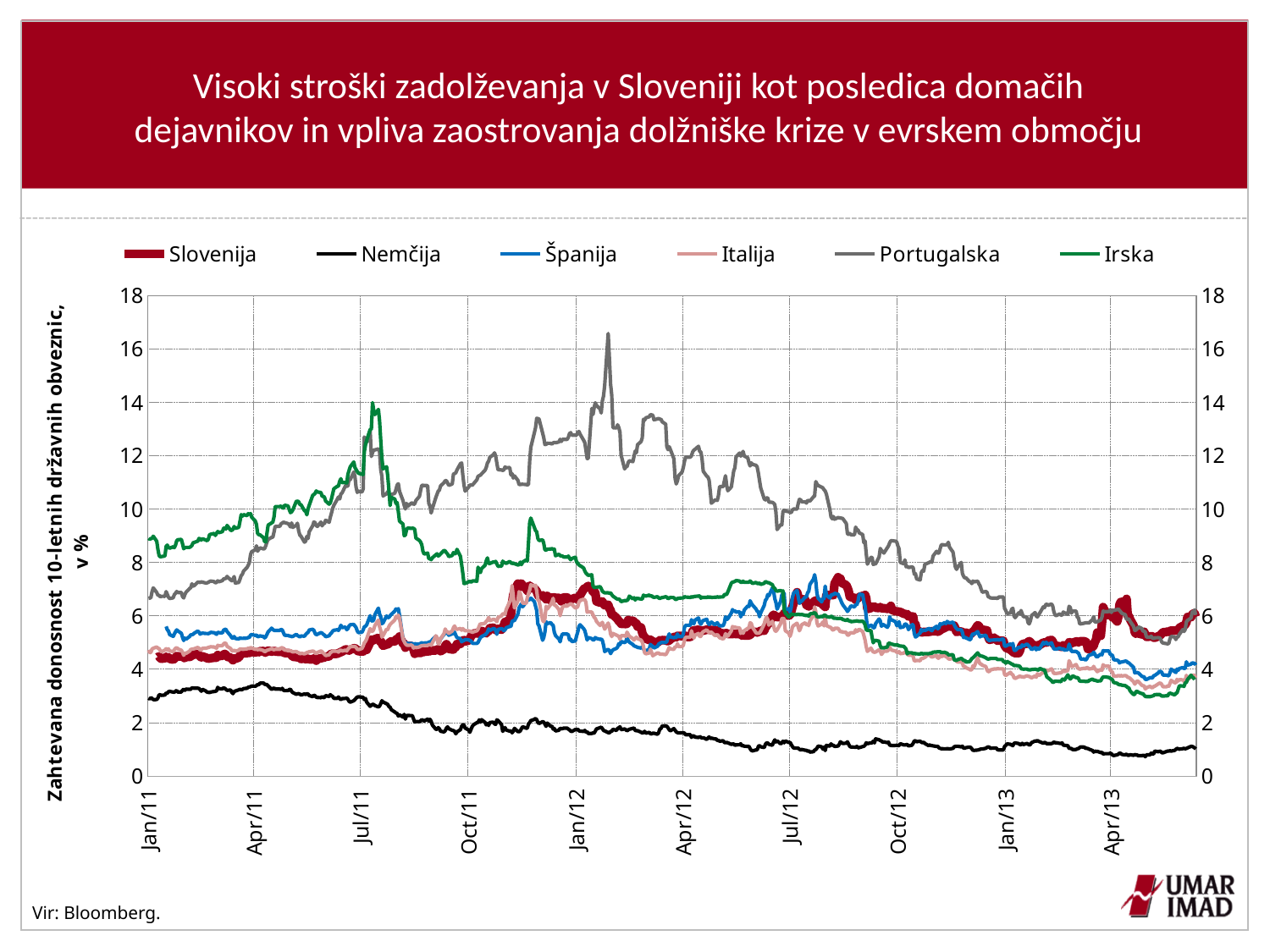
At Jan/11, which is higher, Irska or Slovenija? Irska How many series does the legend list? 6 Does the value for Nemčija rise or fall from Jan/11 to Apr/13? fall Which series has the lowest values across the whole period? Nemčija Which series reaches the highest value on the chart? Portugalska What kind of chart is shown on the slide? line chart Is the peak value for Portugalska greater or less than 14? greater Does the value for Portugalska rise or fall from Jul/12 to Apr/13? fall At Jan/12, which is higher, Portugalska or Nemčija? Portugalska What source is cited for the chart data? Bloomberg Is the peak value for Irska around Jul/11 greater or less than 12? greater Is the value for Nemčija at Jan/11 greater or less than 4? less